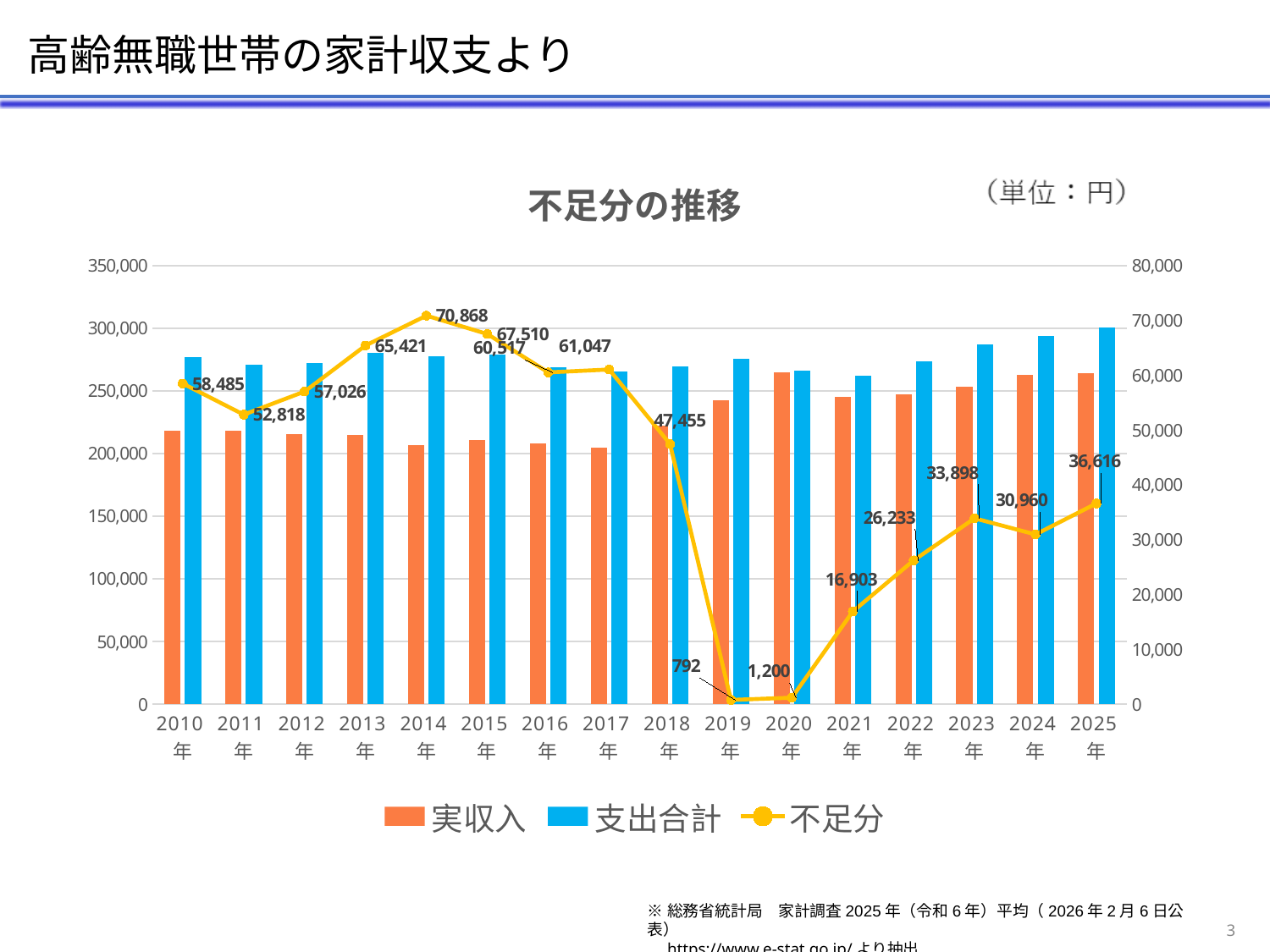
Which year has a larger 不足分, 2023年 or 2024年? 2023年 What kind of chart is this? Combination bar and line chart How many series does the legend list? 3 What is the value of 不足分 for 2019年? 792 What is the value of 不足分 for 2014年? 70,868 What is the value of 不足分 for 2025年? 36,616 In which year is 不足分 the lowest? 2019年 How many years are shown on the x axis? 16 What is the difference between the 不足分 values for 2014年 and 2025年? 34,252 What is the value of 不足分 for 2021年? 16,903 Is the 支出合計 value for 2025年 greater or less than 250,000? greater In which year is 不足分 the highest? 2014年